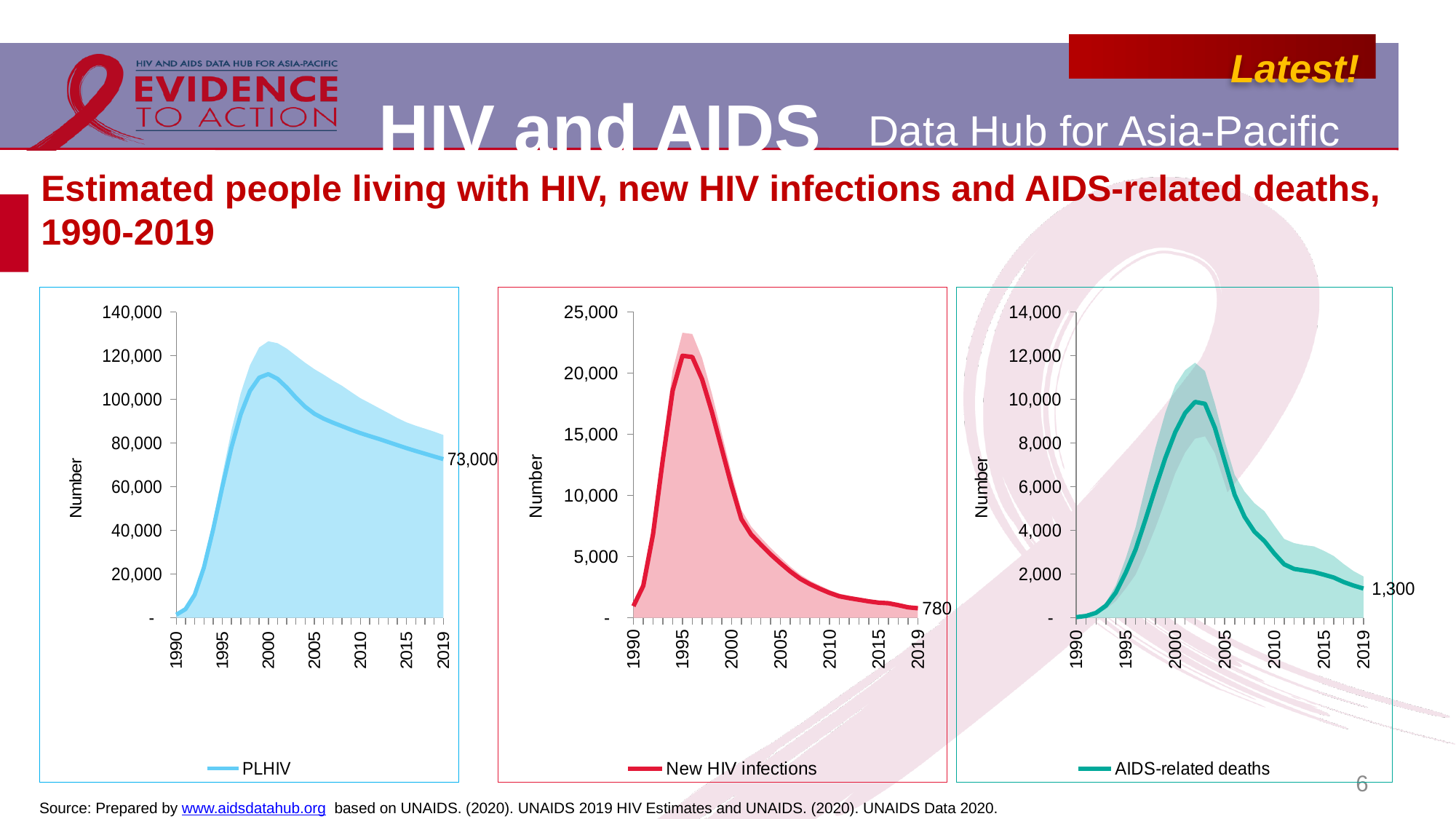
In the left chart (PLHIV), do the values rise or fall between 1990 and 2000? rise In the middle chart (New HIV infections), do the values rise or fall between 2000 and 2019? fall In the middle chart (New HIV infections), is the value for 1995 greater or less than 20,000? greater How many series does the legend of the middle chart list? 1 In the left chart (PLHIV), is the value for 2000 greater or less than 100,000? greater In the middle chart (New HIV infections), what is the value shown for 2019? 780 In the right chart (AIDS-related deaths), which year has the highest value, 2003 or 2019? 2003 In the right chart (AIDS-related deaths), what is the value shown for 2019? 1,300 In the right chart (AIDS-related deaths), is the value for 2010 greater or less than 4,000? less What is the legend entry of the right chart? AIDS-related deaths In the left chart (PLHIV), what is the value shown for 2019? 73,000 What kind of chart is the left chart (PLHIV)? line chart